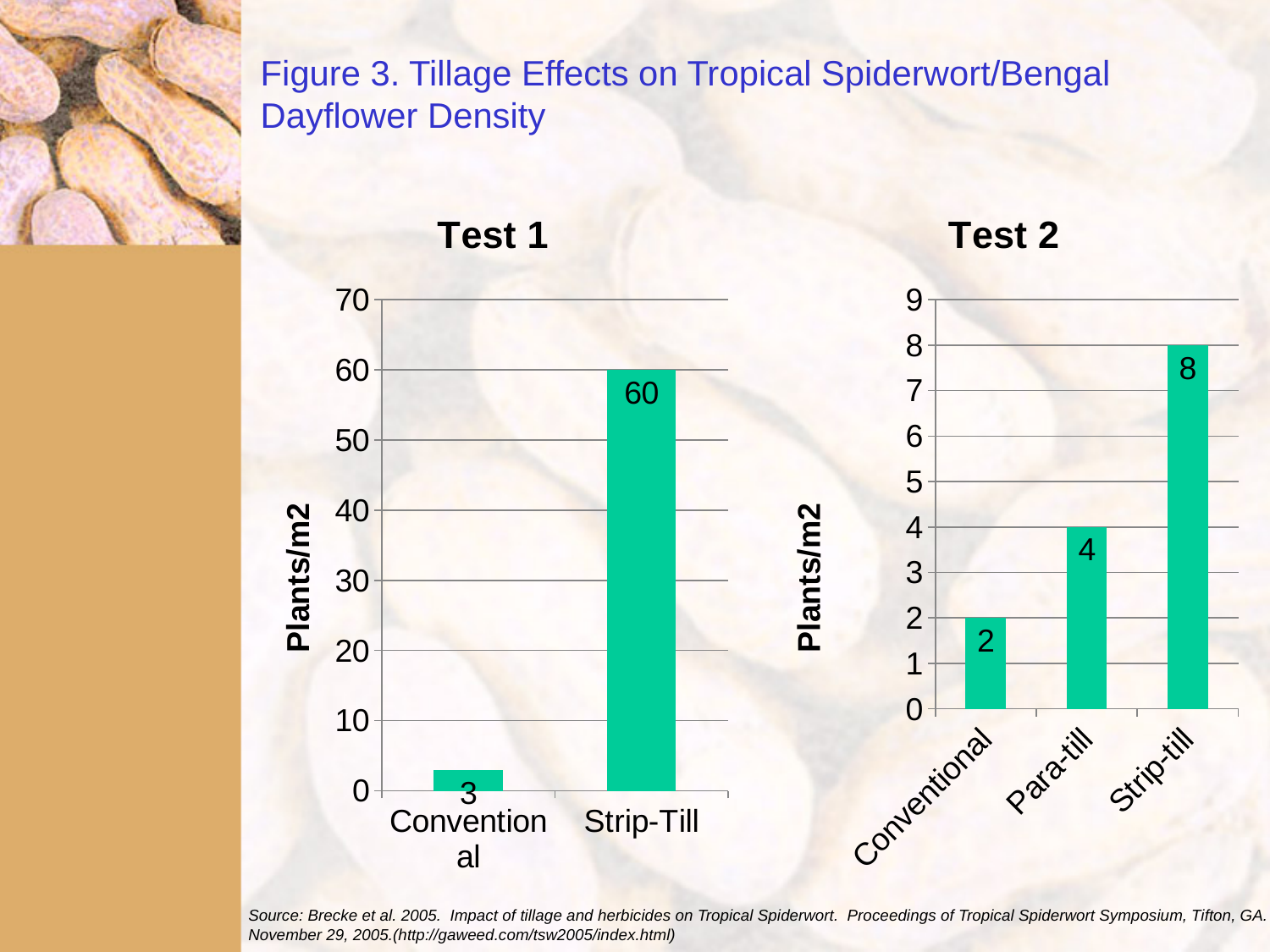
In the Test 1 chart, what is the value for Strip-Till? 60 In the Test 2 chart, which category has the lowest value? Conventional In the Test 2 chart, what is the difference between the Strip-till and Para-till values? 4 In the Test 1 chart, what is the value for Conventional? 3 In the Test 2 chart, which category has the highest value? Strip-till In the Test 1 chart, what is the difference between the Strip-Till and Conventional values? 57 In the Test 2 chart, what is the value for Para-till? 4 What is the y-axis label of the Test 2 chart? Plants/m2 How many categories are shown in the Test 2 chart? 3 In the Test 1 chart, which is larger, Conventional or Strip-Till? Strip-Till What type of chart is the Test 1 chart? Bar chart In the Test 2 chart, what is the value for Conventional? 2